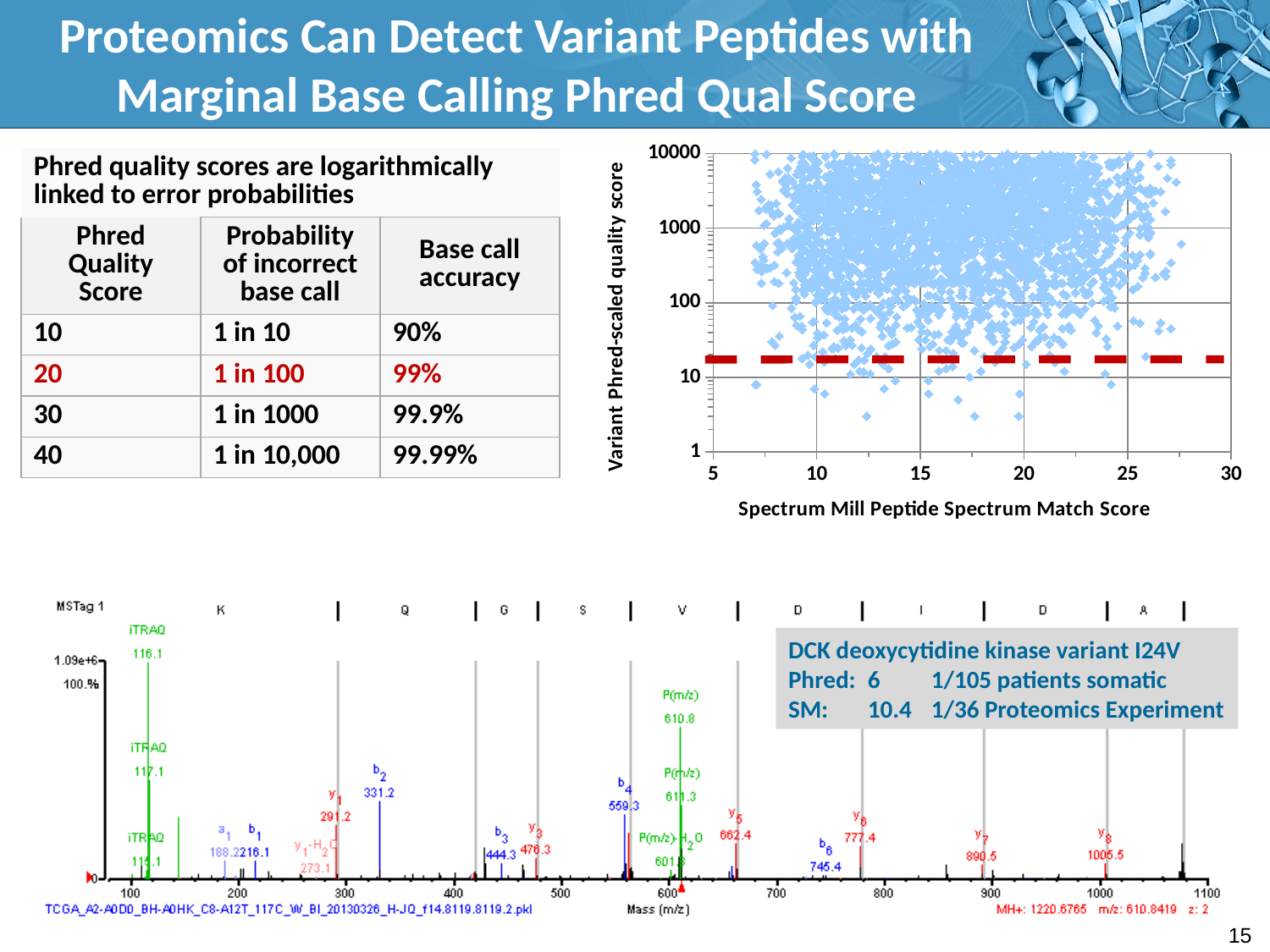
In the bottom mass spectrum chart, what is the label of the x axis? Mass (m/z) In the bottom mass spectrum chart, what is the m/z value labelled for the y6 peak? 777.4 In the bottom mass spectrum chart, what is the m/z value labelled for the y8 peak? 1005.5 In the top-right scatter plot, what is the label of the x axis? Spectrum Mill Peptide Spectrum Match Score In the top-right scatter plot, what is the lowest tick value shown on the x axis? 5 In the top-right scatter plot, what is the highest tick value shown on the y axis? 10000 In the bottom mass spectrum chart, what is the m/z value labelled for the b2 peak? 331.2 What kind of chart is the top-right chart with the axis 'Spectrum Mill Peptide Spectrum Match Score'? scatter plot In the top-right scatter plot, what is the highest tick value shown on the x axis? 30 In the top-right scatter plot, is the dashed red horizontal line above or below the y-axis value of 10? above In the top-right scatter plot, is the dashed red horizontal line above or below the y-axis value of 100? below In the top-right scatter plot, what is the label of the y axis? Variant Phred-scaled quality score